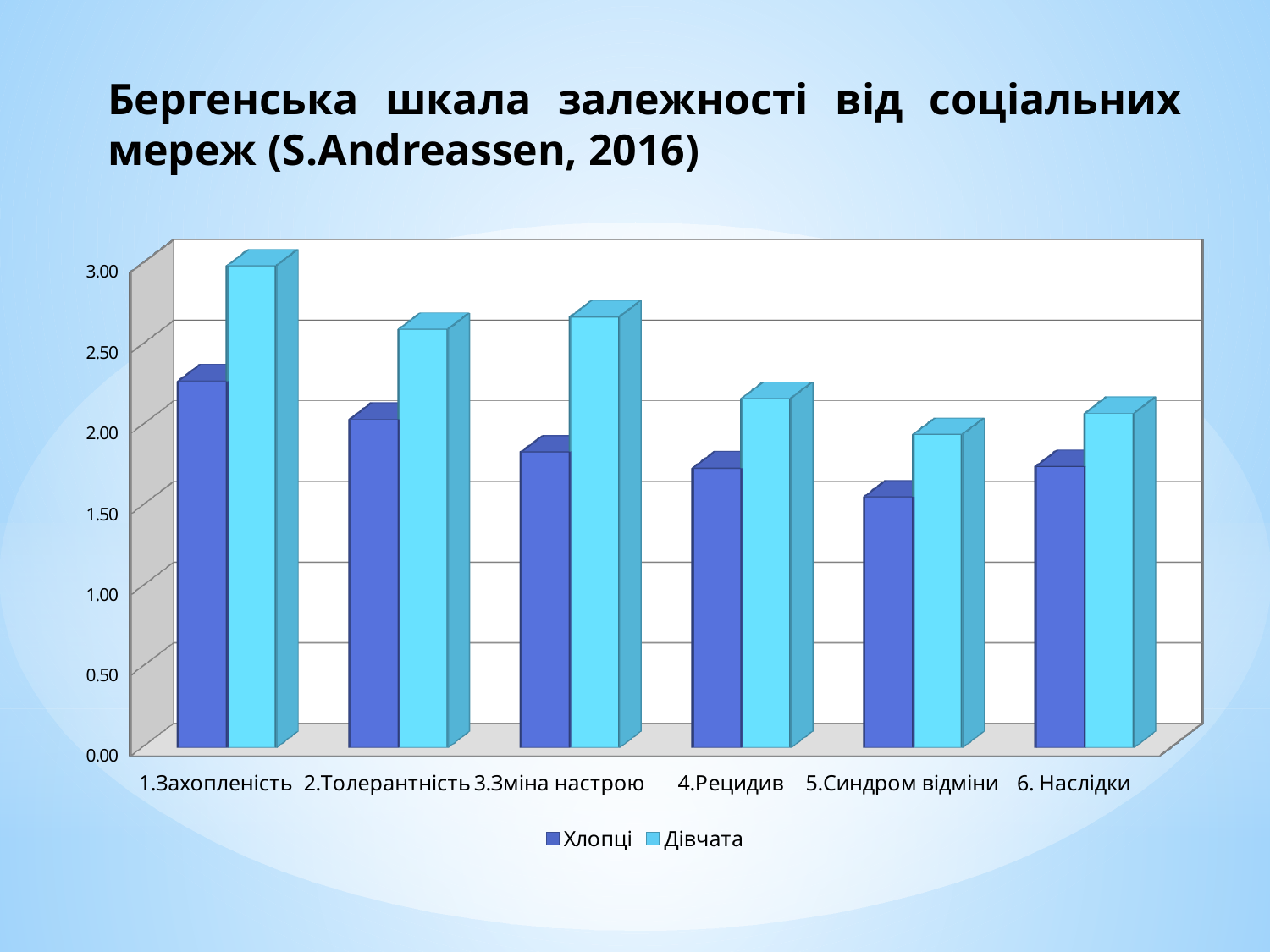
For which category is the value for Дівчата the highest? 1.Захопленість Is the value for Дівчата in 2.Толерантність greater or less than 2.50? greater Is the value for Хлопці in 1.Захопленість greater or less than 2.00? greater Which is larger in 3.Зміна настрою, the value for Хлопці or for Дівчата? Дівчата How many categories are shown on the x axis of the chart? 6 Which is larger in 6. Наслідки, the value for Хлопці or for Дівчата? Дівчата What are the two series named in the legend? Хлопці and Дівчата For which category is the value for Хлопці the highest? 1.Захопленість For which category is the value for Хлопці the lowest? 5.Синдром відміни How many series does the chart's legend list? 2 Is the value for Хлопці in 4.Рецидив greater or less than 2.00? less What kind of chart is shown on the slide? Bar chart